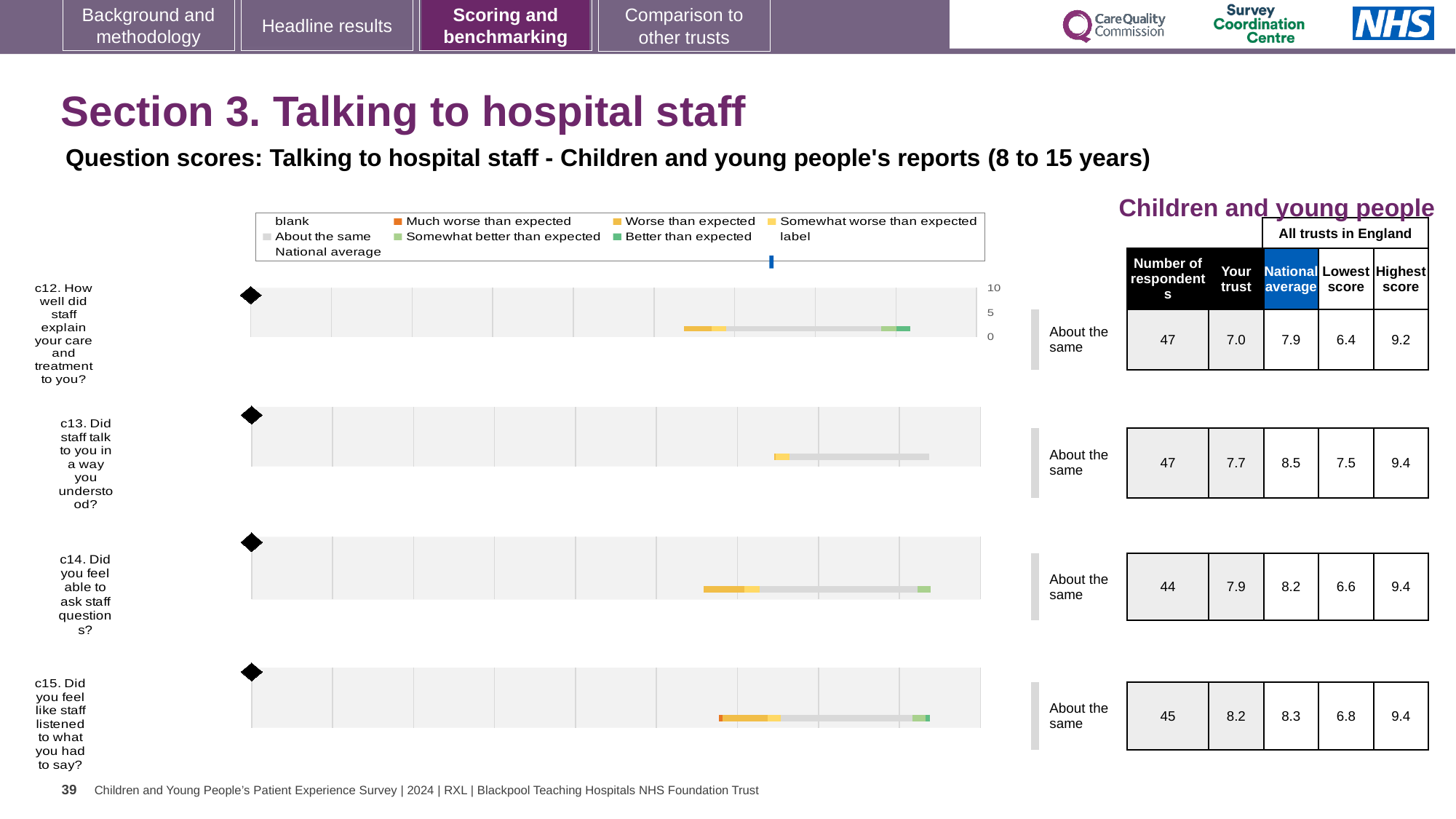
How many question charts (c12 to c15) are shown on the slide? 4 What is the lowest score across all trusts in England shown for c15 (Did you feel like staff listened to what you had to say?)? 6.8 What benchmark category is shown next to the c14 chart? About the same What is the national average shown for c13 (Did staff talk to you in a way you understood?)? 8.5 For c12, what is the difference between the national average and the 'Your trust' score? 0.9 Which question has the highest 'Your trust' score? c15 In the legend, which colour represents 'Much worse than expected'? Orange For c13, which is larger: the 'Your trust' score or the national average? National average What is the 'Your trust' score shown for c12 (How well did staff explain your care and treatment to you?)? 7.0 What is the highest score across all trusts in England shown for c14 (Did you feel able to ask staff questions?)? 9.4 Which question has the lowest 'Your trust' score? c12 What kind of chart is used for each question (c12 to c15)? bar chart